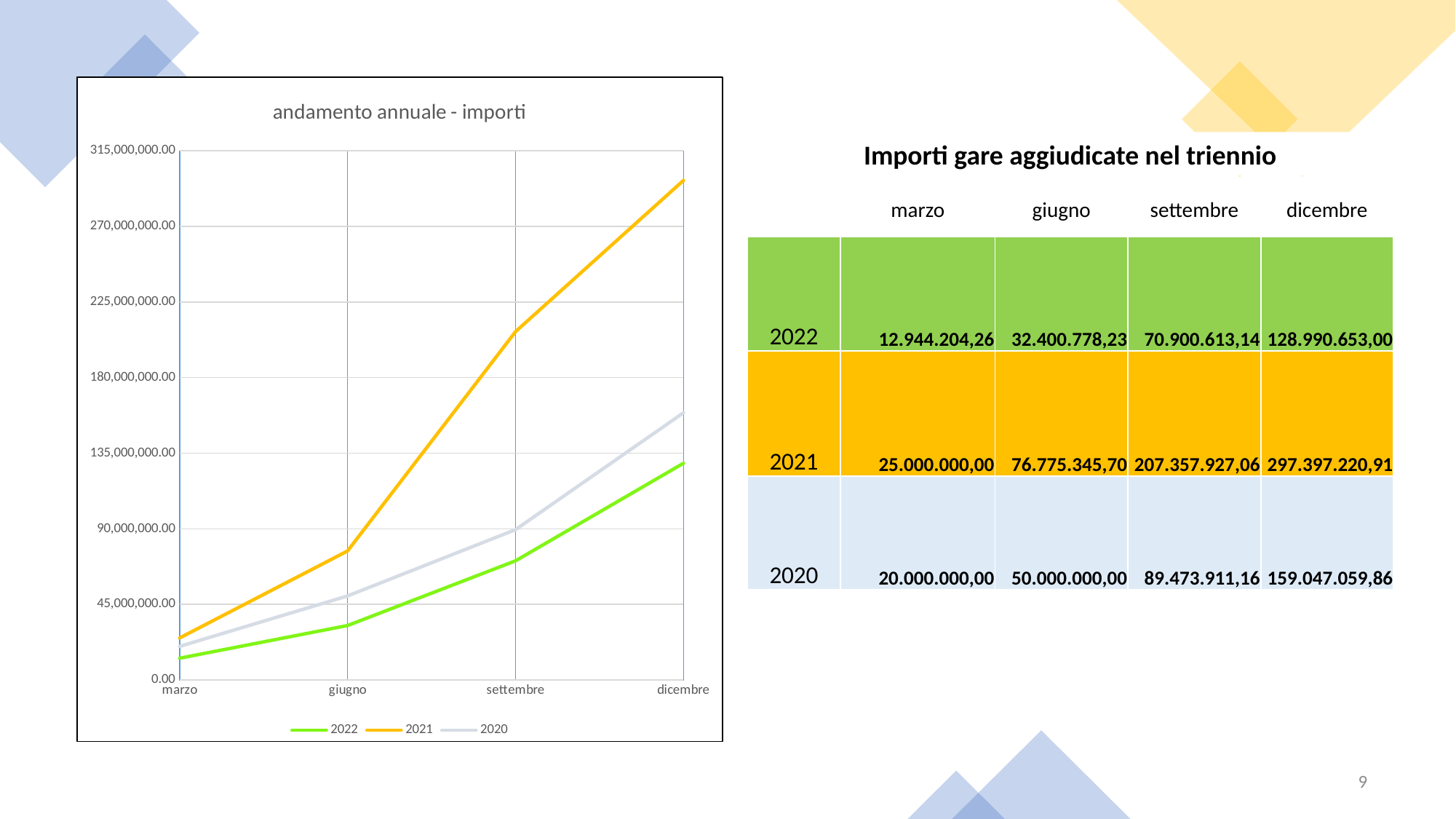
What kind of chart is shown on the left of the slide? line chart In the chart 'andamento annuale - importi', is the value for 2020 at dicembre greater or less than 135,000,000.00? greater In the chart 'andamento annuale - importi', which is larger at giugno, the value for 2021 or the value for 2020? 2021 In the chart 'andamento annuale - importi', which series has the lowest value at marzo? 2022 How many points along the x axis does each line in the chart 'andamento annuale - importi' have? 4 According to the table 'Importi gare aggiudicate nel triennio', what is the value for 2022 at dicembre? 128.990.653,00 Using the values in the table 'Importi gare aggiudicate nel triennio', what is the difference between the dicembre values for 2021 and 2020? 138.350.161,05 How many series does the legend of the chart 'andamento annuale - importi' list? 3 What is the title of the line chart on the left of the slide? andamento annuale - importi In the chart 'andamento annuale - importi', is the value for 2021 at settembre greater or less than 180,000,000.00? greater In the chart 'andamento annuale - importi', do the values for 2021 rise or fall from marzo to dicembre? rise In the chart 'andamento annuale - importi', which series has the highest value at dicembre? 2021